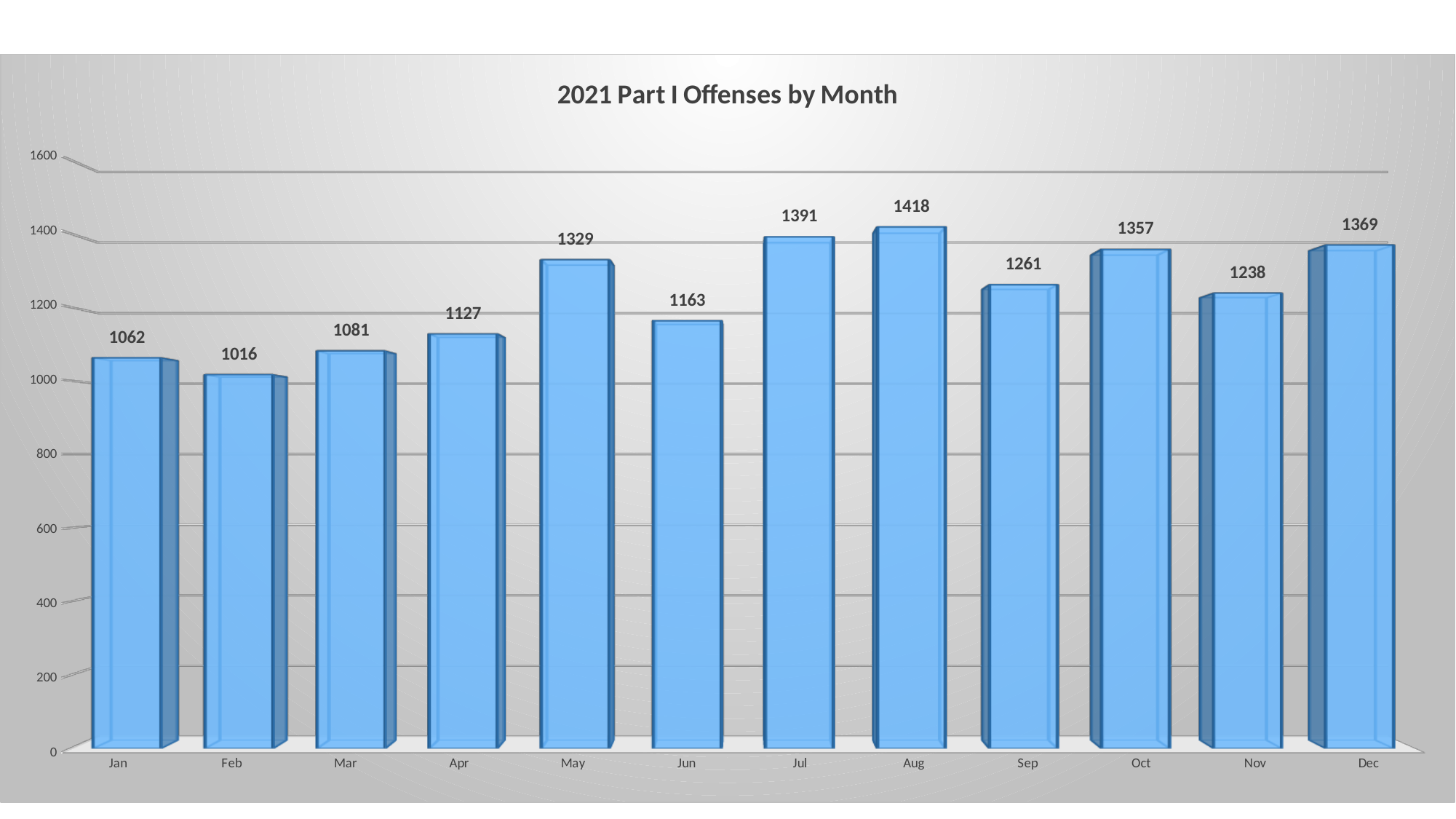
Which month has the highest value? Aug What is the difference between the values for Aug and Feb? 402 What is the value for Feb? 1016 What is the title of the chart? 2021 Part I Offenses by Month What is the value for Aug? 1418 Which month has the lowest value? Feb What is the value for Oct? 1357 Is the value for Jun greater or less than 1200? less What is the difference between the values for Jul and Jun? 228 How many months are shown on the x axis? 12 What kind of chart is this? bar chart Which is larger, the value for May or the value for Sep? May